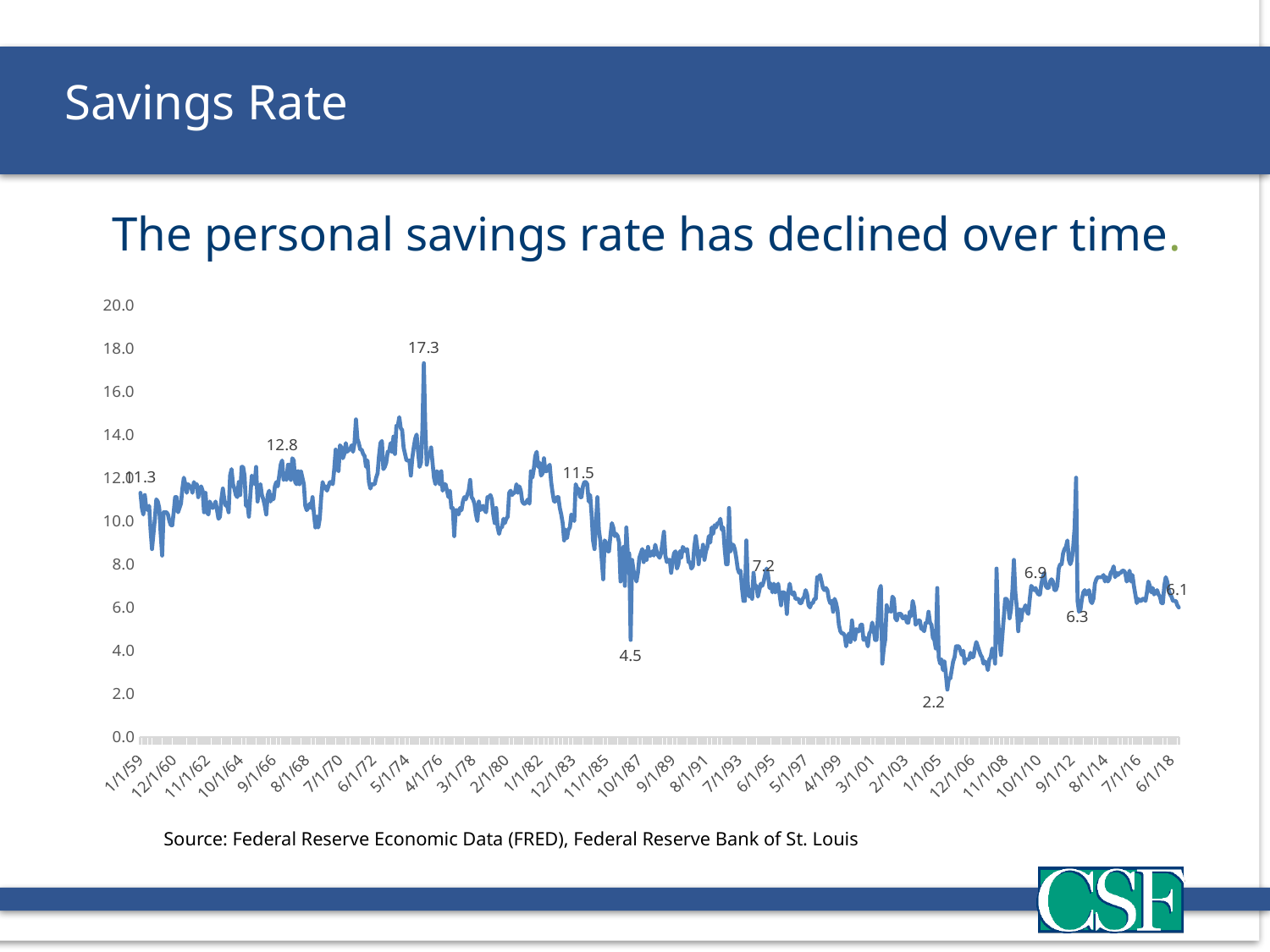
What labeled value appears near 10/1/87 at the low dip of the line? 4.5 What is the highest labeled value on the savings rate line? 17.3 What is the lowest labeled value on the savings rate line? 2.2 What source is cited below the chart? Federal Reserve Economic Data (FRED), Federal Reserve Bank of St. Louis What is the last labeled value at the right end of the line (near 6/1/18)? 6.1 What is the difference between the labeled values 11.5 and 4.5? 7.0 What kind of chart is shown on the slide? line chart Overall, does the personal savings rate rise or fall from 1959 to 2018? fall Which is larger, the labeled value 6.9 or the labeled value 6.3? 6.9 What is the difference between the highest labeled value (17.3) and the lowest labeled value (2.2)? 15.1 What is the maximum value shown on the vertical axis? 20.0